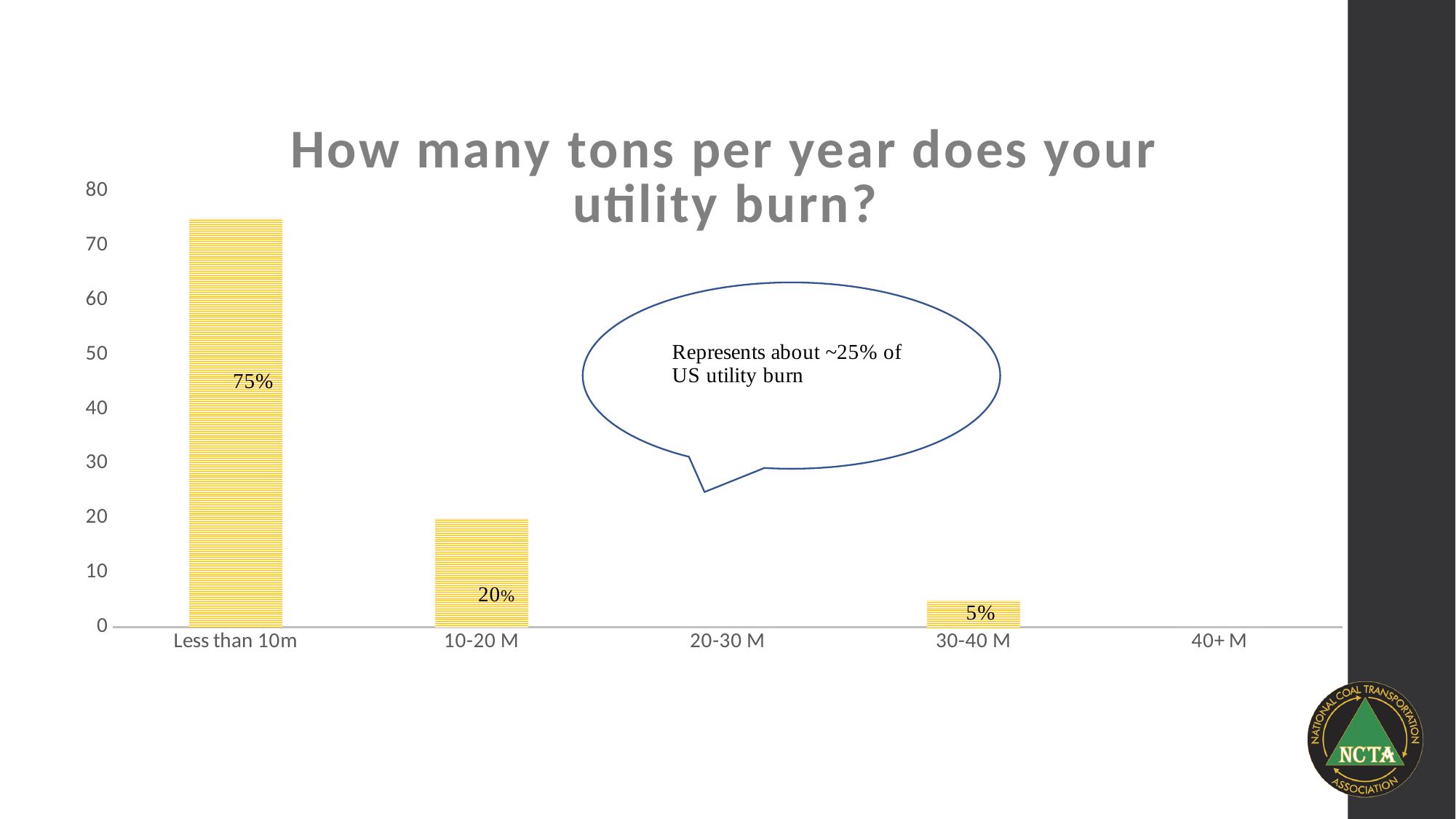
Is the value for "Less than 10m" greater or less than 70? greater Which is larger, the value for "10-20 M" or the value for "30-40 M"? 10-20 M What is the value labelled on the bar for "30-40 M"? 5% What is the difference between the values for "Less than 10m" and "10-20 M"? 55% What is the title of the chart? How many tons per year does your utility burn? What does the callout bubble on the chart say? Represents about ~25% of US utility burn What kind of chart is shown on the slide? Bar chart Which of the labelled bars has the lowest value? 30-40 M What is the value labelled on the bar for "Less than 10m"? 75% Which category has the highest value? Less than 10m How many categories are shown on the x axis? 5 What is the value labelled on the bar for "10-20 M"? 20%